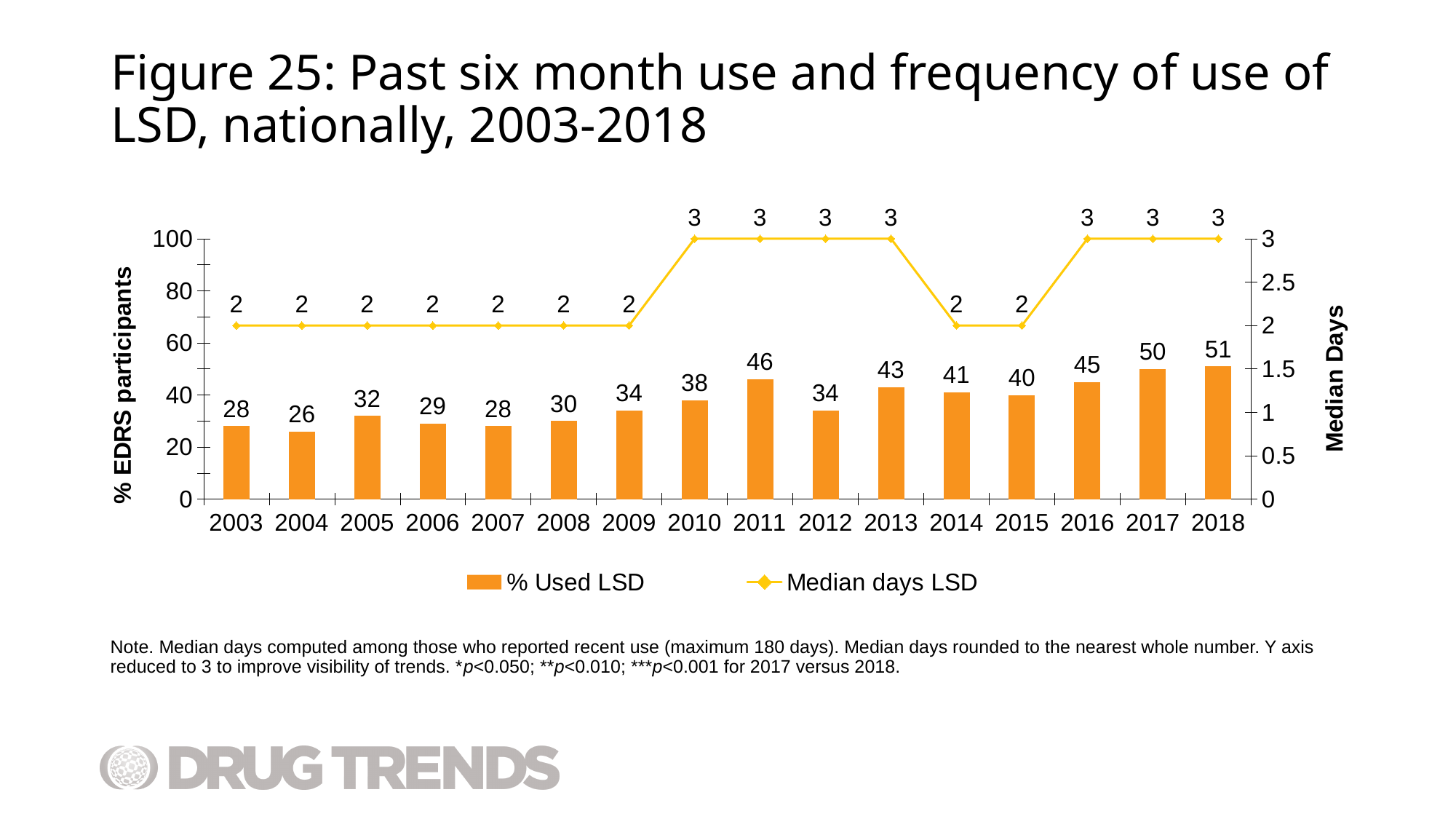
What is the difference in % Used LSD between 2018 and 2003? 23 Does % Used LSD rise or fall from 2015 to 2018? rise Which year has a higher % Used LSD, 2010 or 2013? 2013 Which year has the highest % Used LSD? 2018 Is the % Used LSD value for 2017 greater or less than 40? greater What is the value of % Used LSD in 2011? 46 What is the title of the right-hand y axis? Median Days What is the Median days LSD value for 2014? 2 What kind of chart is used to show % Used LSD? bar chart Which year has the lowest % Used LSD? 2004 How many years are shown on the x axis? 16 How many series does the legend list? 2